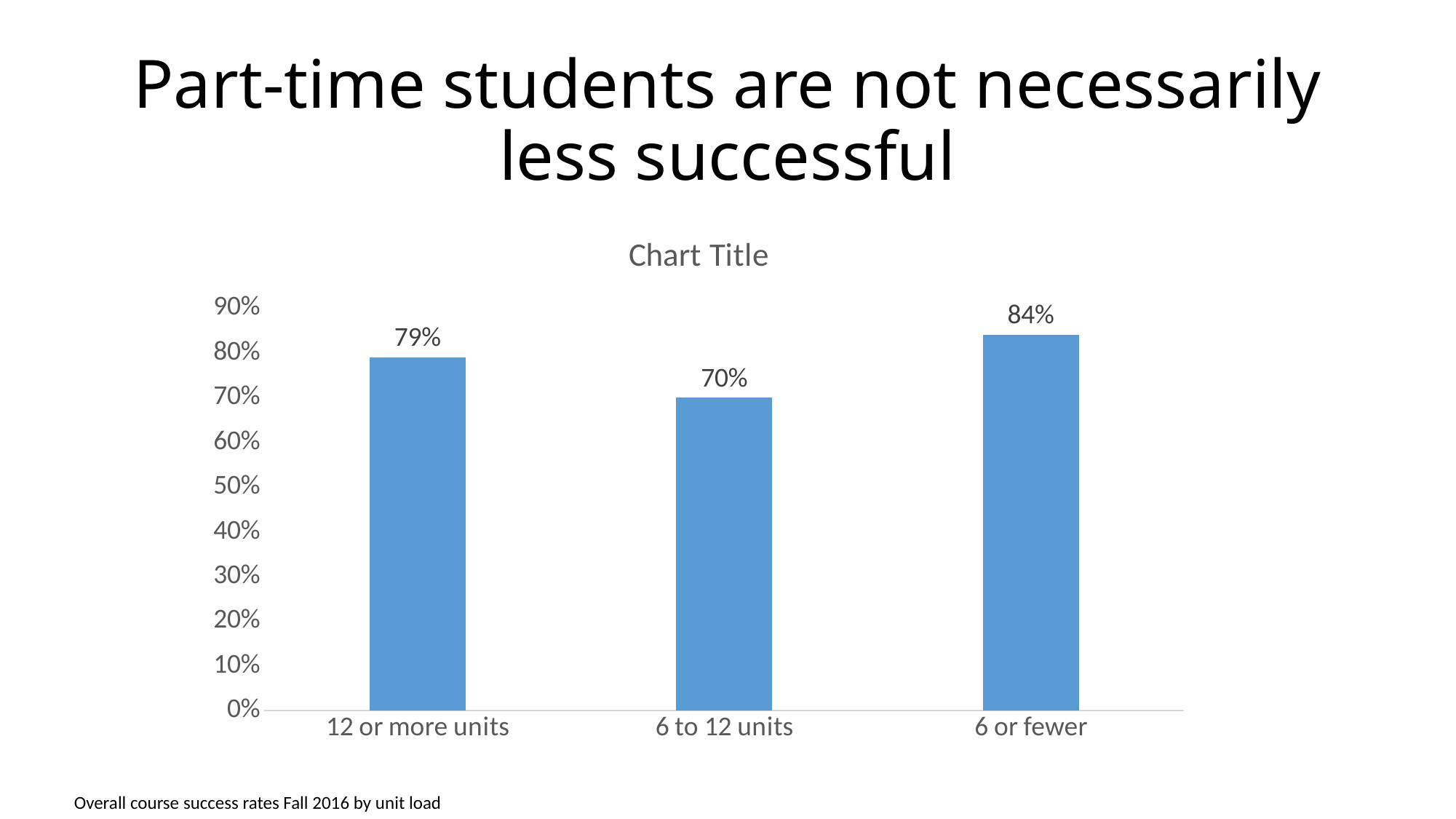
Which category has the highest value? 6 or fewer Is the value for 6 to 12 units greater or less than 80%? less Which is larger, the value for 12 or more units or the value for 6 or fewer? 6 or fewer What kind of chart is shown on the slide? bar chart What is the title shown above the chart? Chart Title What is the value for 6 to 12 units? 70% What is the difference between the values for 6 or fewer and 6 to 12 units? 14% What is the difference between the values for 12 or more units and 6 to 12 units? 9% What is the value for 12 or more units? 79% What is the value for 6 or fewer? 84% How many categories are shown on the x axis? 3 Which category has the lowest value? 6 to 12 units